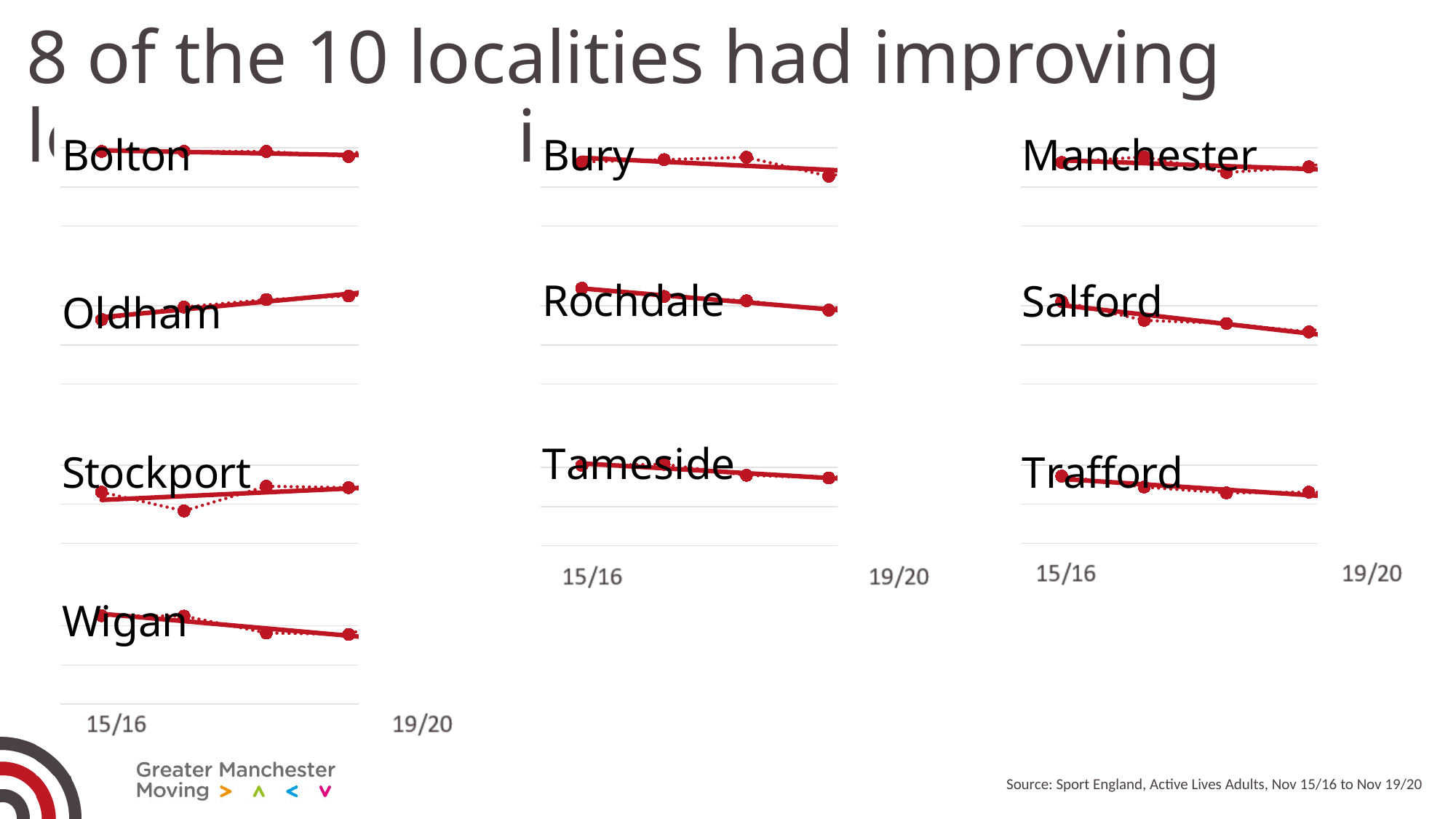
How many data points are plotted in the Oldham chart? 4 How many locality charts are shown on the slide? 10 What is the last x-axis label shown under the charts? 19/20 What is the first x-axis label shown under the charts? 15/16 In the Rochdale chart, do the values rise or fall from 15/16 to 19/20? fall In the Oldham chart, do the values rise or fall from 15/16 to 19/20? rise In the Bury chart, do the values rise or fall from 15/16 to 19/20? fall What kind of chart is used for each locality on the slide? line chart